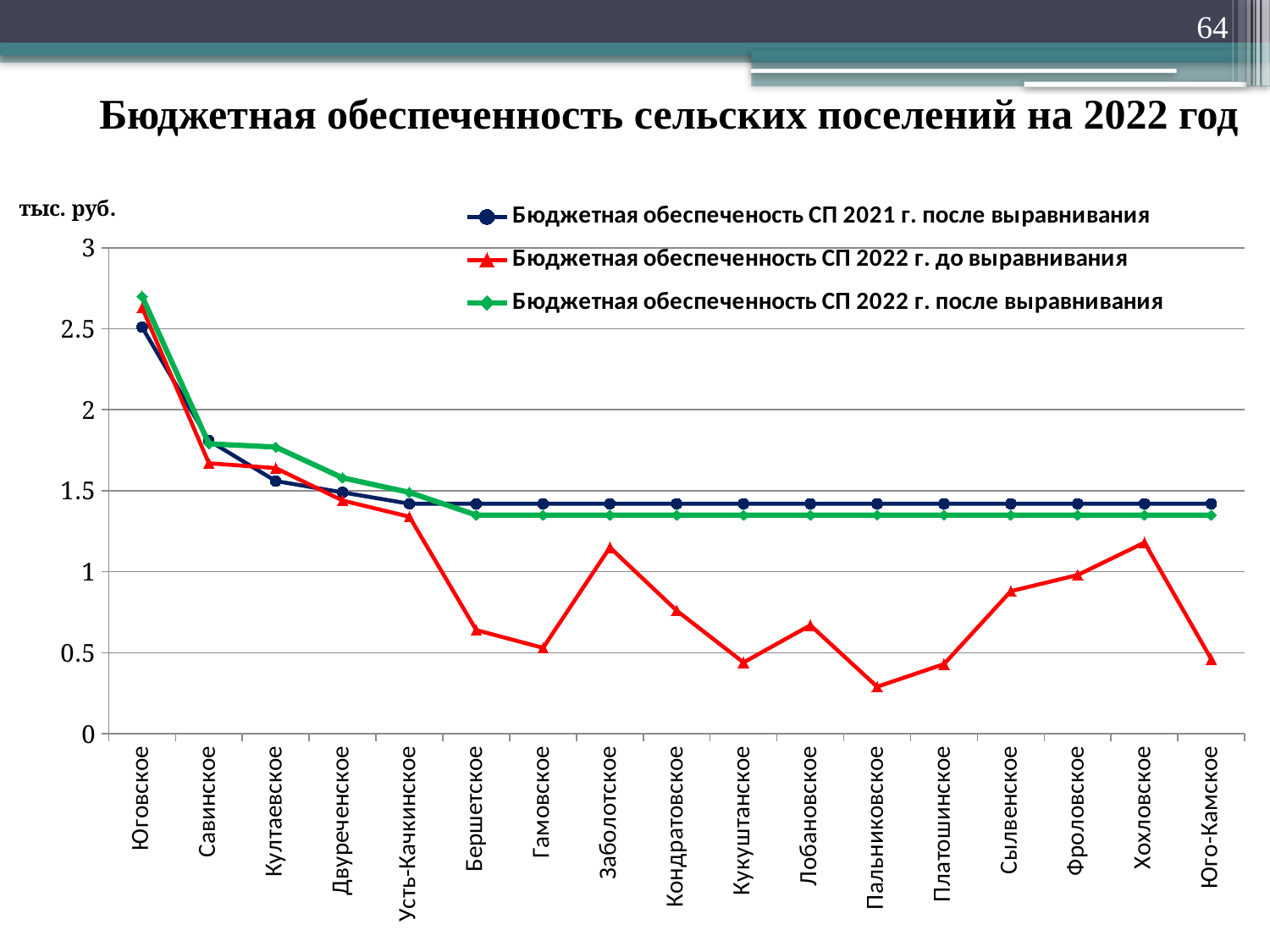
Does the series 'Бюджетная обеспеченность СП 2022 г. до выравнивания' rise or fall from Юговское to Усть-Качкинское? Fall What kind of chart is shown on the slide? Line chart Is the value for Юговское in the series 'Бюджетная обеспеченность СП 2022 г. после выравнивания' greater or less than 2.5? greater How many series does the legend list? 3 For Култаевское, which series has the larger value: 'Бюджетная обеспеченность СП 2022 г. после выравнивания' or 'Бюджетная обеспеченость СП 2021 г. после выравнивания'? Бюджетная обеспеченность СП 2022 г. после выравнивания What unit is shown above the y axis of the chart? тыс. руб. Which settlement has the lowest value for the series 'Бюджетная обеспеченность СП 2022 г. до выравнивания'? Пальниковское Is the value for Кукуштанское in the series 'Бюджетная обеспеченность СП 2022 г. до выравнивания' greater or less than 0.5? less How many settlements (categories) are plotted along the x axis? 17 Is the value for Заболотское in the series 'Бюджетная обеспеченность СП 2022 г. до выравнивания' greater or less than 1? greater For Пальниковское, which series has the larger value: 'Бюджетная обеспеченность СП 2022 г. после выравнивания' or 'Бюджетная обеспеченность СП 2022 г. до выравнивания'? Бюджетная обеспеченность СП 2022 г. после выравнивания Which settlement has the highest value for the series 'Бюджетная обеспеченность СП 2022 г. до выравнивания'? Юговское